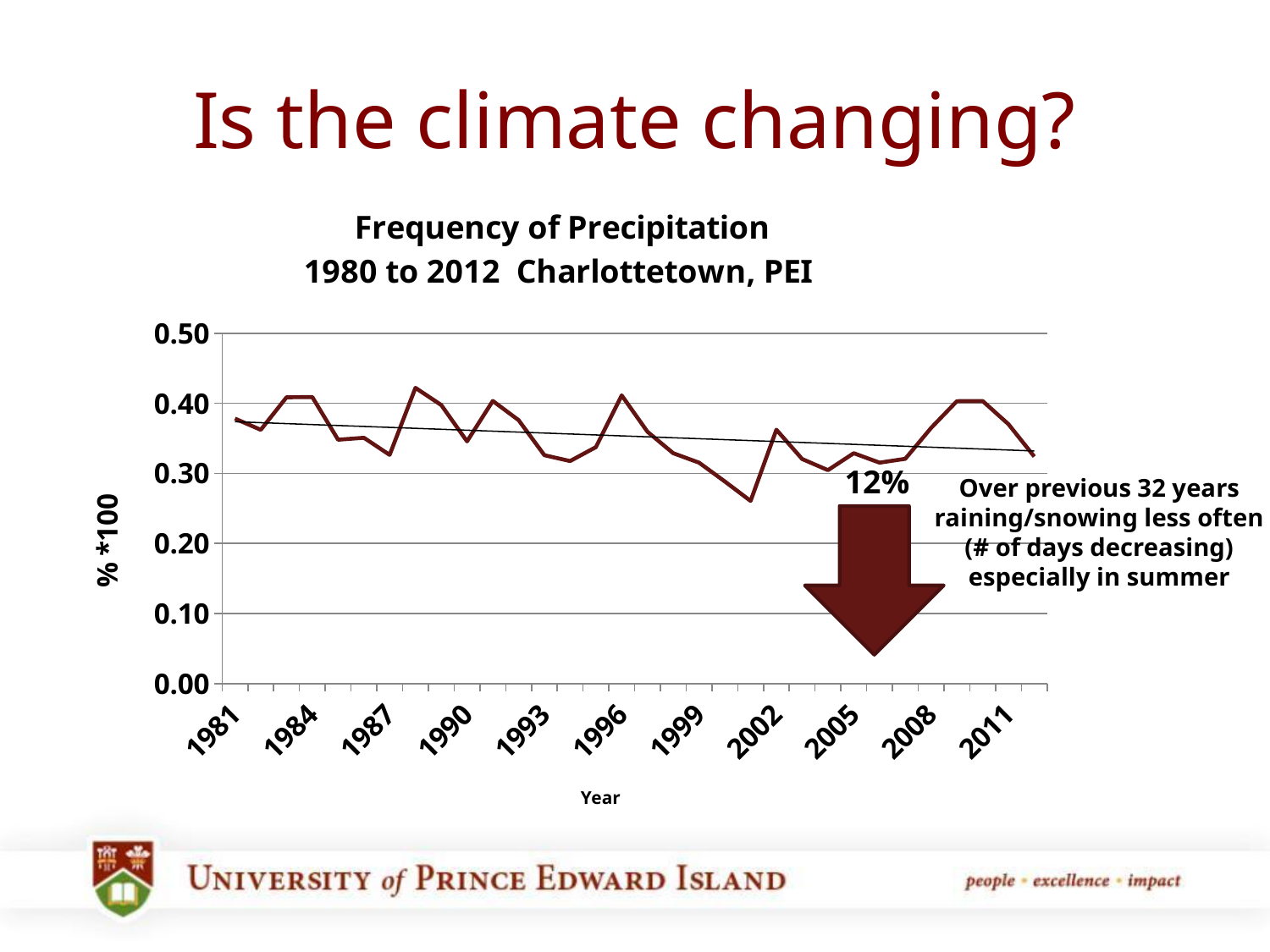
What percentage is printed next to the downward arrow on the chart? 12% Is the highest point on the line greater or less than 0.40? greater Is the value for 1996 greater or less than 0.50? less What kind of chart is shown on the slide? line chart Is the lowest point on the line greater or less than 0.30? less How many year labels are shown along the x axis? 11 What is the title of the chart? Frequency of Precipitation 1980 to 2012 Charlottetown, PEI What is the label on the vertical axis of the chart? % *100 What is the highest value shown on the vertical axis? 0.50 According to the trend line, do the values generally rise or fall from 1981 to 2011? fall